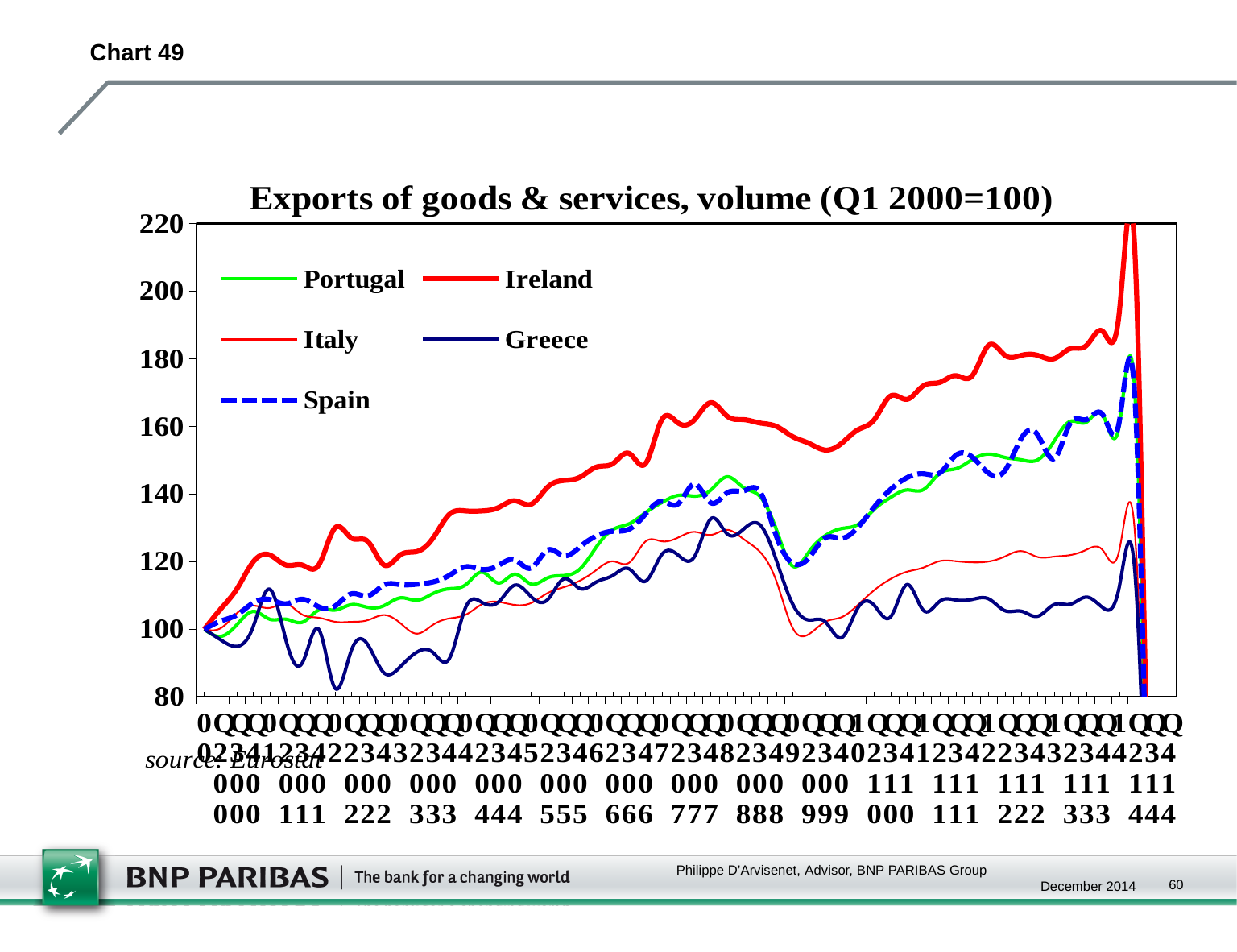
Which country's series is the highest for almost the entire period shown? Ireland How many series does the legend list? 5 Is the value for Greece at its low point around 2002 greater or less than 100? less Which country's series is the lowest for most of the period from 2010 onward? Greece Does the Ireland series generally rise or fall from 2000 to 2013? rise What kind of chart is shown on the slide? line chart In 2008, which is larger, the value for Ireland or the value for Italy? Ireland Is the value for Italy during 2013 greater or less than 140? less Is the value for Portugal at the start of 2009 greater or less than 140? less Which series is drawn as a dashed line? Spain What is the title of the chart? Exports of goods & services, volume (Q1 2000=100)